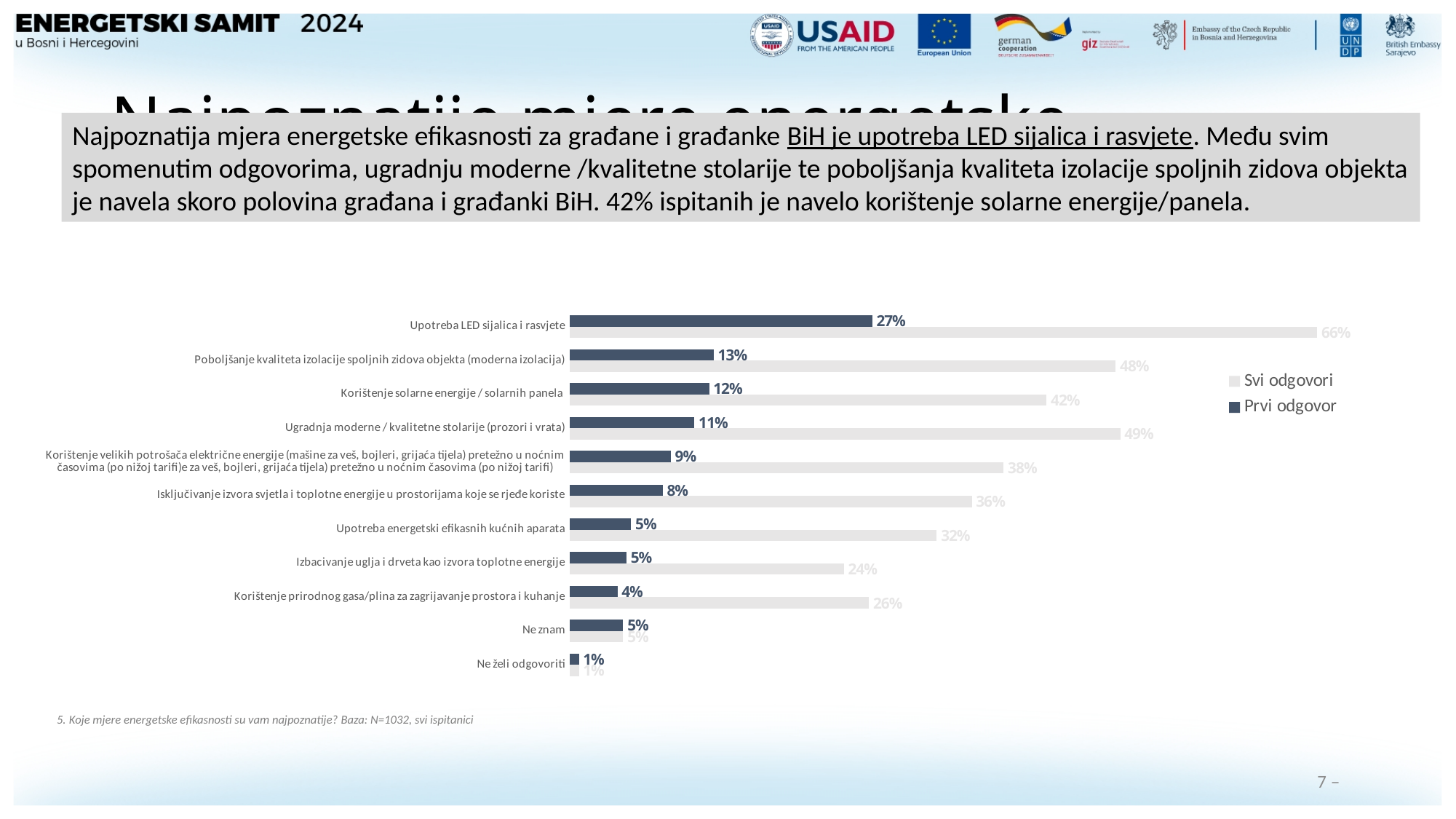
Which has a larger 'Svi odgovori' value: 'Izbacivanje uglja i drveta kao izvora toplotne energije' or 'Korištenje prirodnog gasa/plina za zagrijavanje prostora i kuhanje'? Korištenje prirodnog gasa/plina za zagrijavanje prostora i kuhanje What is the 'Svi odgovori' value for 'Upotreba LED sijalica i rasvjete'? 66% What kind of chart is shown on the slide? bar chart Which category has the lowest 'Svi odgovori' value? Ne želi odgovoriti What is the 'Prvi odgovor' value for 'Korištenje solarne energije / solarnih panela'? 12% How many series does the legend list? 2 What is the difference between the 'Svi odgovori' and 'Prvi odgovor' values for 'Upotreba LED sijalica i rasvjete'? 39% Which legend entry is shown in the dark colour? Prvi odgovor What is the 'Prvi odgovor' value for 'Ne znam'? 5% What is the 'Svi odgovori' value for 'Ugradnja moderne / kvalitetne stolarije (prozori i vrata)'? 49% Which category has the highest 'Prvi odgovor' value? Upotreba LED sijalica i rasvjete How many categories are shown on the chart? 11